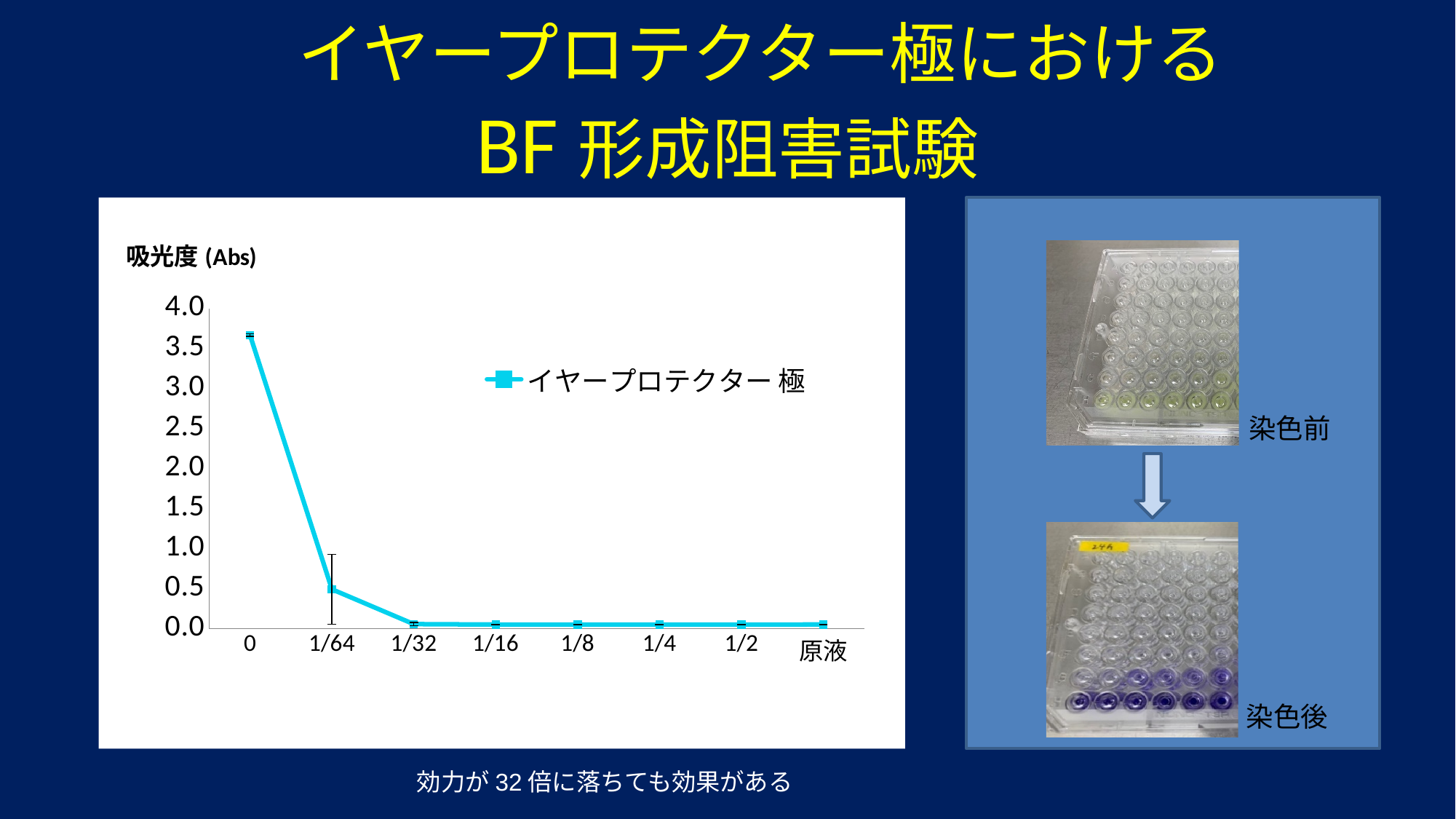
What is the label of the y axis? 吸光度 (Abs) Which is larger, the value at 0 or the value at 1/64? 0 What kind of chart is shown on the slide? line chart How many series does the legend list? 1 How many points are plotted along the x axis? 8 Is the value at 1/32 greater or less than 0.5? less Which x-axis category has the highest absorbance value? 0 Is the value at 原液 greater or less than 0.5? less Is the value at x = 0 greater or less than 3.0? greater Do the values rise or fall moving from 0 to 1/32 along the x axis? fall What is the name of the series shown in the legend? イヤープロテクター 極